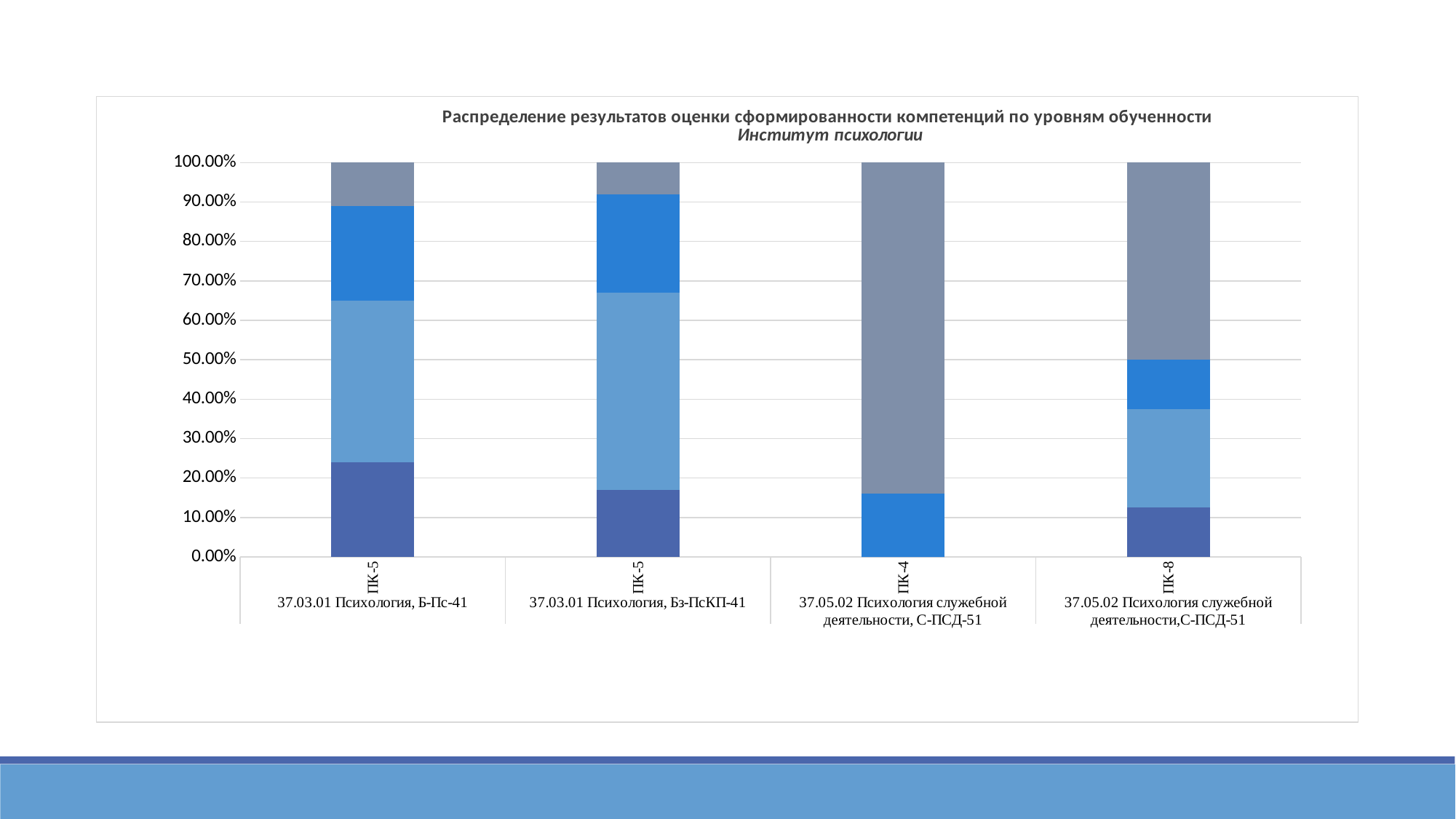
What kind of chart is shown on the slide? stacked bar chart Which bar has the smallest grey (top) segment? ПК-5 (37.03.01 Психология, Бз-ПсКП-41) Is the top of the bright blue segment for ПК-8 (37.05.02 Психология служебной деятельности, С-ПСД-51) greater or less than 60.00%? less What is the total height of the stacked bar for ПК-4 (37.05.02 Психология служебной деятельности, С-ПСД-51)? 100.00% How many categories (bars) are plotted on the chart? 4 Which bar has the largest grey (top) segment? ПК-4 (37.05.02 Психология служебной деятельности, С-ПСД-51) Is the top of the bright blue segment for ПК-4 (37.05.02 Психология служебной деятельности, С-ПСД-51) greater or less than 20.00%? less Is the top of the bottom (dark blue) segment for ПК-5 (37.03.01 Психология, Б-Пс-41) greater or less than 20.00%? greater What is the total height of the stacked bar for ПК-5 (37.03.01 Психология, Б-Пс-41)? 100.00% What is the title of the chart? Распределение результатов оценки сформированности компетенций по уровням обученности Институт психологии